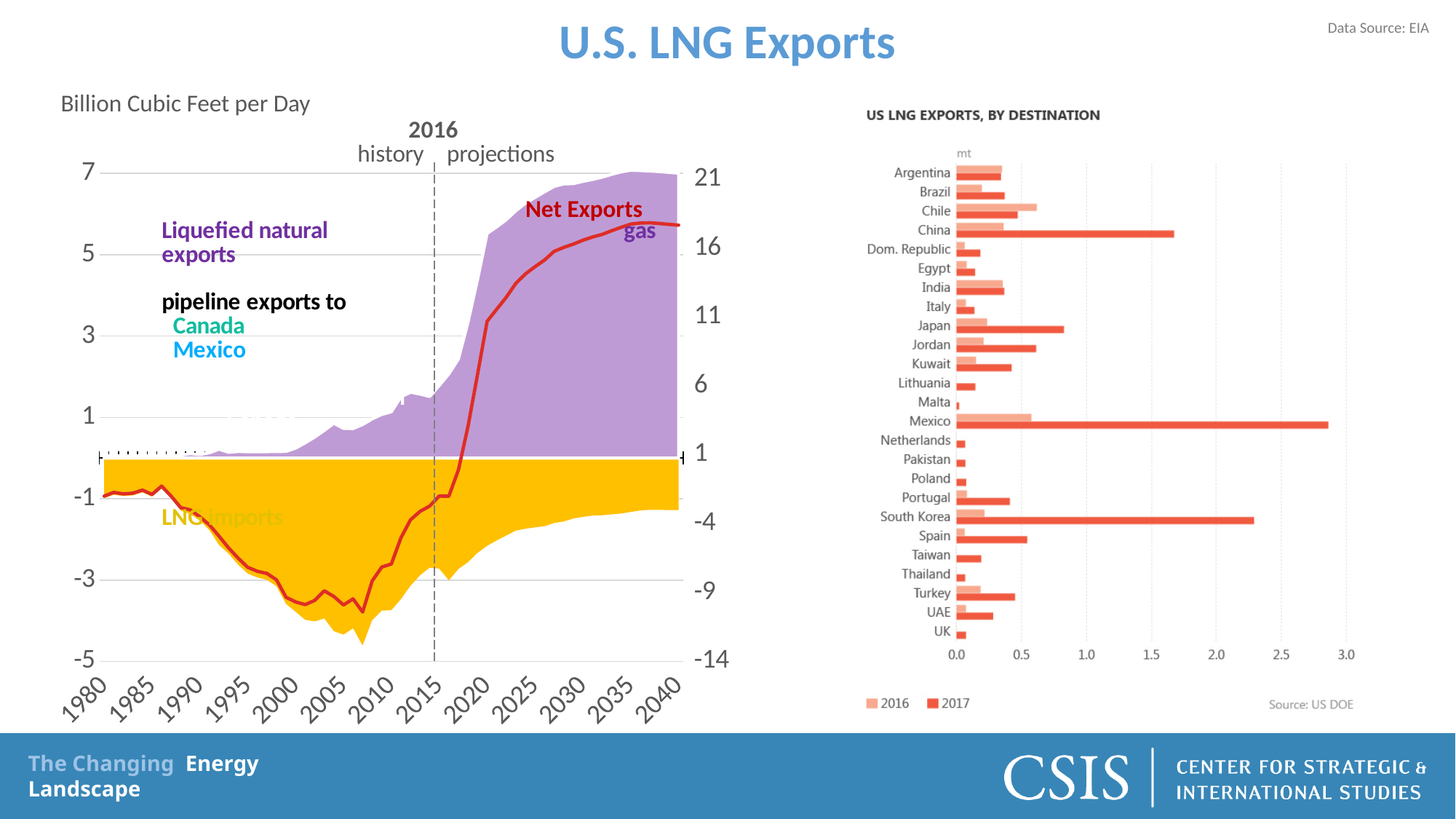
What type of chart is the 'US LNG EXPORTS, BY DESTINATION' chart on the right? bar chart In the 'US LNG EXPORTS, BY DESTINATION' chart, is the 2017 value for Mexico greater or less than 2.5? greater In the left chart, what year does the dashed line separating history from projections mark? 2016 In the 'US LNG EXPORTS, BY DESTINATION' chart, how many destination countries are listed? 25 In the 'US LNG EXPORTS, BY DESTINATION' chart, which is larger, the 2017 value for China or the 2017 value for Japan? China In the 'US LNG EXPORTS, BY DESTINATION' chart, which is larger for Chile, the 2016 value or the 2017 value? 2016 In the 'US LNG EXPORTS, BY DESTINATION' chart, which destination has the highest 2017 value? Mexico In the 'US LNG EXPORTS, BY DESTINATION' chart, is the 2017 value for South Korea greater or less than 2.0? greater In the 'US LNG EXPORTS, BY DESTINATION' chart, is the 2017 value for Japan greater or less than 1.0? less In the left chart, do Net Exports rise or fall between 2020 and 2040? rise In the 'US LNG EXPORTS, BY DESTINATION' chart, what unit is shown on the value axis? mt In the 'US LNG EXPORTS, BY DESTINATION' chart, how many series does the legend list? 2